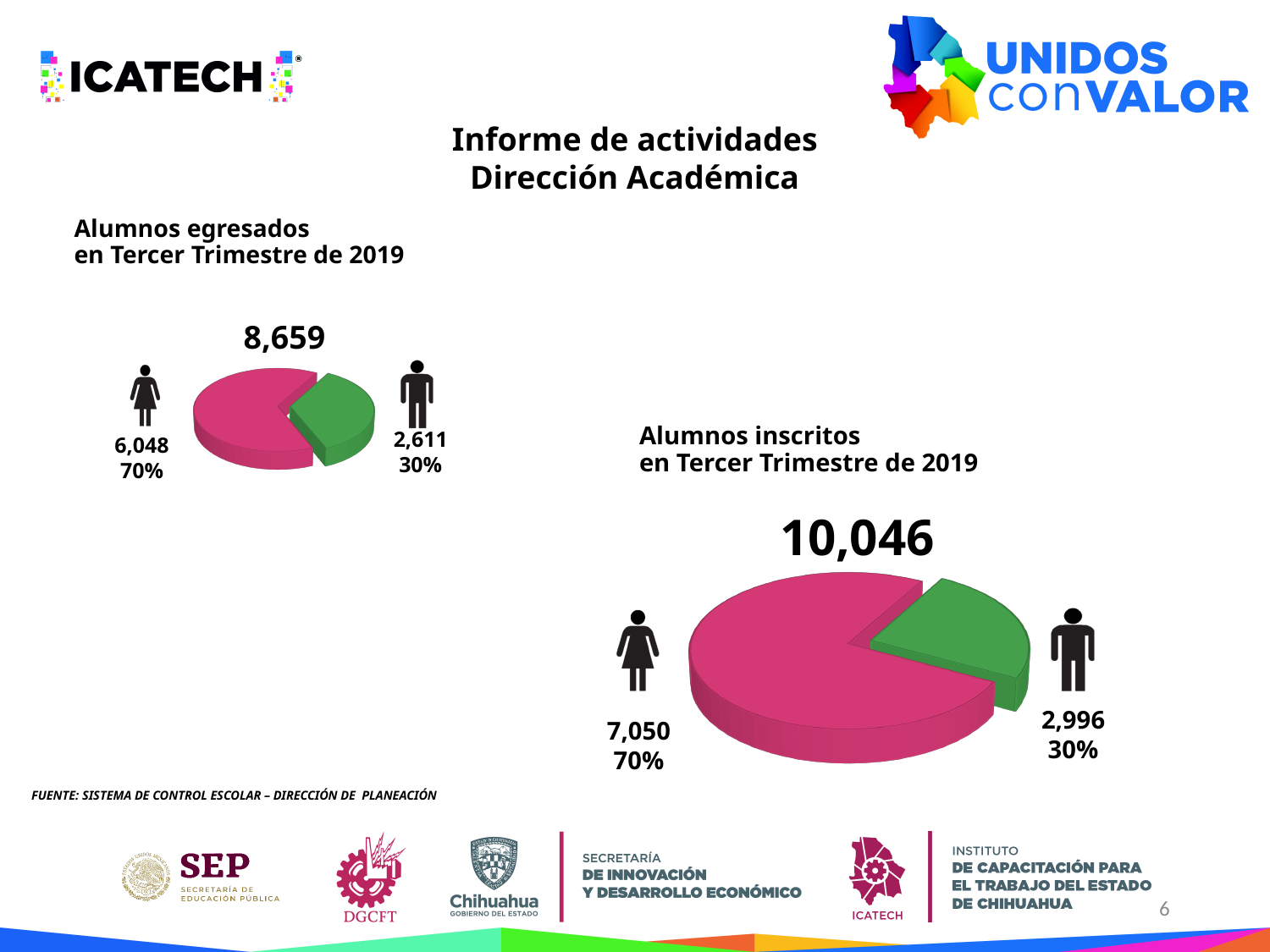
In the 'Alumnos egresados en Tercer Trimestre de 2019' chart, what value is shown next to the male icon? 2,611 In the 'Alumnos inscritos en Tercer Trimestre de 2019' chart, what value is shown next to the male icon? 2,996 In the 'Alumnos egresados en Tercer Trimestre de 2019' chart, what is the total number shown above the pie? 8,659 In the 'Alumnos inscritos en Tercer Trimestre de 2019' chart, which slice is larger, the female or the male one? female In the 'Alumnos egresados en Tercer Trimestre de 2019' chart, what is the difference between the female and male values? 3,437 What type of chart is used for 'Alumnos egresados en Tercer Trimestre de 2019'? pie chart In the 'Alumnos inscritos en Tercer Trimestre de 2019' chart, what share of the pie does the female slice represent? 70% In the 'Alumnos egresados en Tercer Trimestre de 2019' chart, what share of the pie does the male slice represent? 30% In the 'Alumnos inscritos en Tercer Trimestre de 2019' chart, what colour is the larger slice? pink In the 'Alumnos egresados en Tercer Trimestre de 2019' chart, what value is shown next to the female icon? 6,048 In the 'Alumnos inscritos en Tercer Trimestre de 2019' chart, what value is shown next to the female icon? 7,050 In the 'Alumnos inscritos en Tercer Trimestre de 2019' chart, what is the total number shown above the pie? 10,046